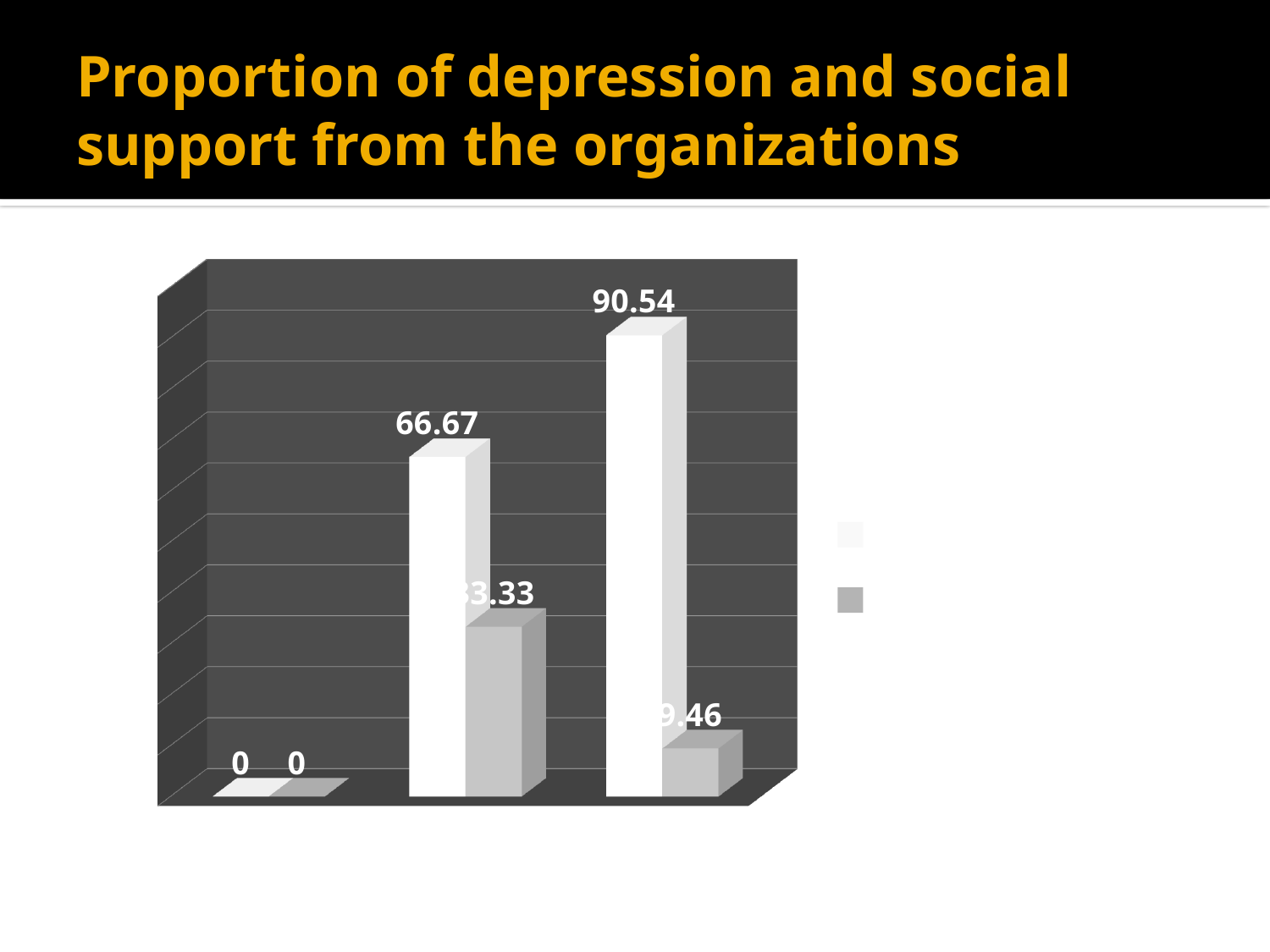
What are the values of the two bars in the first (leftmost) group? 0 and 0 How many series does the legend list? 2 What is the difference between the white bar in the third group and the white bar in the second group? 23.87 Do the values of the white bars rise or fall from left to right along the x axis? rise What kind of chart is shown on the slide? bar chart What is the title of the slide containing the chart? Proportion of depression and social support from the organizations In the second (middle) group, which is larger, the white bar or the grey bar? the white bar What is the value of the white bar in the third (rightmost) group? 90.54 What is the value of the white bar in the second (middle) group? 66.67 What is the value of the grey bar in the third (rightmost) group? 9.46 Which bar has the highest value in the chart? the white bar in the third (rightmost) group How many groups of bars are plotted along the x axis? 3